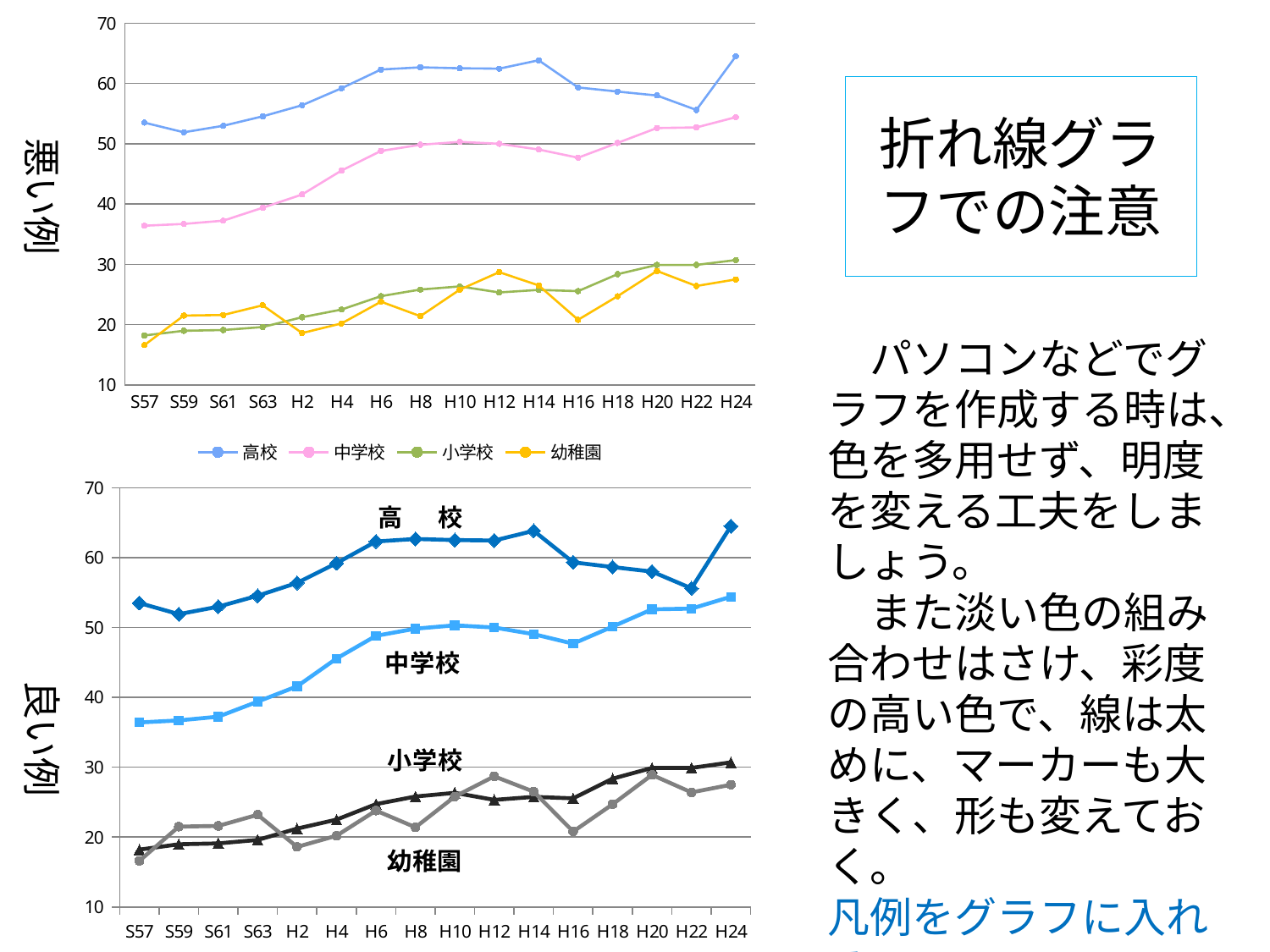
How many points are on the x axis of the bottom chart (良い例)? 16 In the top chart (悪い例), which series has the lowest value at S57? 幼稚園 In the bottom chart (良い例), is the value for 幼稚園 at S57 greater or less than 20? less In the top chart (悪い例), do the values for 高校 generally rise or fall from S57 to H24? rise In the top chart (悪い例), what colour is the line for 中学校? pink What kind of chart is the top chart labelled 悪い例? line chart In the bottom chart (良い例), is the value for 高校 at H24 greater or less than 60? greater In the top chart (悪い例), is the value for 中学校 at S57 greater or less than 40? less In the bottom chart (良い例), which series has the highest values across the whole period? 高校 In the bottom chart (良い例), which is larger at H16, 小学校 or 幼稚園? 小学校 How many series does the legend of the top chart (悪い例) list? 4